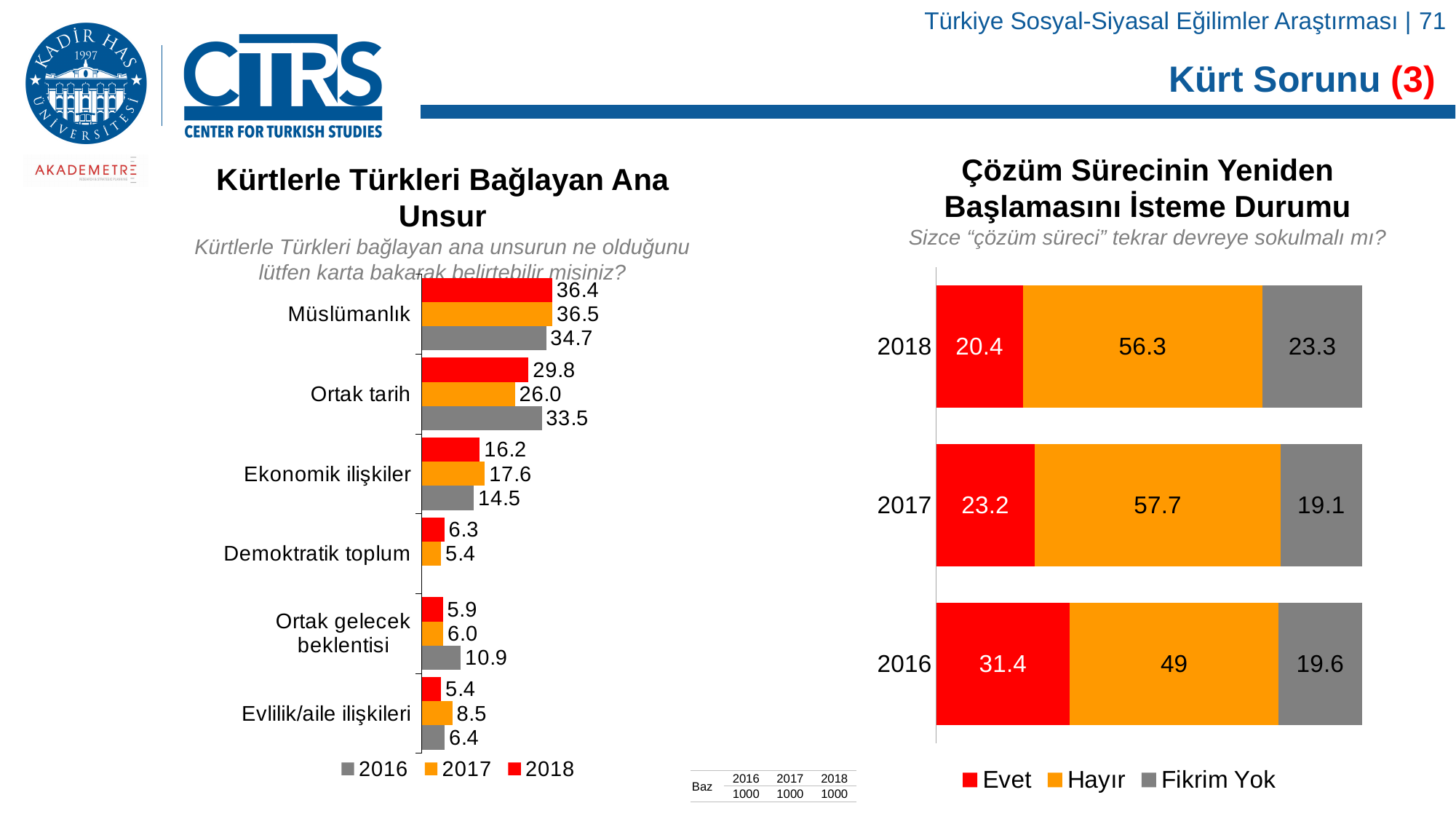
In the chart 'Kürtlerle Türkleri Bağlayan Ana Unsur', how many series does the legend list? 3 In the chart 'Kürtlerle Türkleri Bağlayan Ana Unsur', which category has the lowest 2018 value? Evlilik/aile ilişkileri In the chart 'Çözüm Sürecinin Yeniden Başlamasını İsteme Durumu', what is the total of the 2016 bar? 100 In the chart 'Kürtlerle Türkleri Bağlayan Ana Unsur', what is the difference between the 2018 and 2017 values for Ortak tarih? 3.8 In the chart 'Kürtlerle Türkleri Bağlayan Ana Unsur', what is the 2016 value for Ortak tarih? 33.5 In the chart 'Çözüm Sürecinin Yeniden Başlamasını İsteme Durumu', is the Evet value larger for 2018 or 2017? 2017 In the chart 'Çözüm Sürecinin Yeniden Başlamasını İsteme Durumu', what is the Hayır value for 2017? 57.7 In the chart 'Kürtlerle Türkleri Bağlayan Ana Unsur', which category has the highest 2017 value? Müslümanlık What kind of chart is 'Çözüm Sürecinin Yeniden Başlamasını İsteme Durumu'? Stacked bar chart In the chart 'Kürtlerle Türkleri Bağlayan Ana Unsur', how many categories are shown? 6 In the chart 'Kürtlerle Türkleri Bağlayan Ana Unsur', what is the 2018 value for Müslümanlık? 36.4 In the chart 'Çözüm Sürecinin Yeniden Başlamasını İsteme Durumu', which year has the highest Evet value? 2016